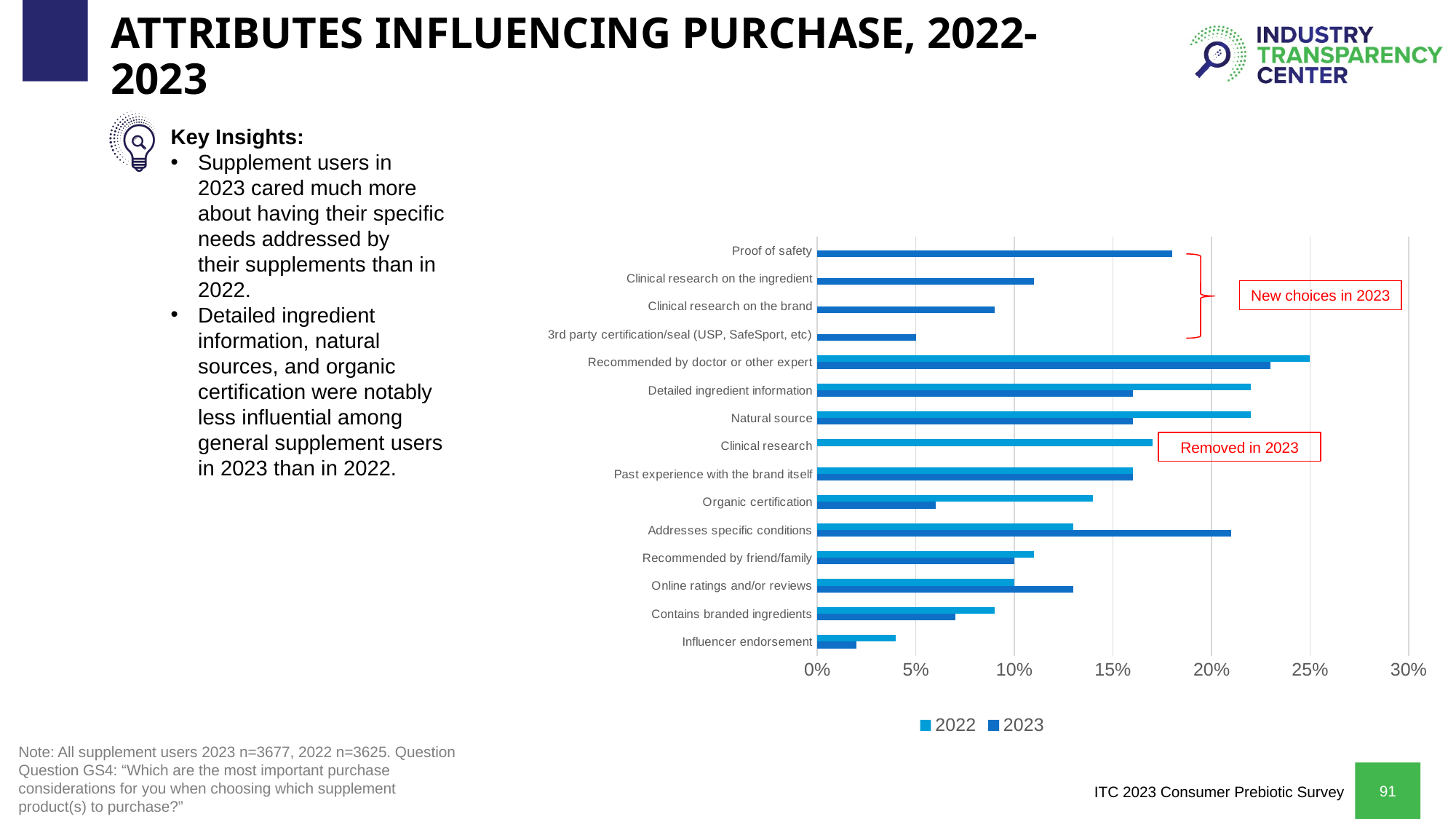
Is the 2023 value for Proof of safety greater or less than 15%? greater Which attribute has the lowest 2023 value? Influencer endorsement For Organic certification, which year has the larger value, 2022 or 2023? 2022 What kind of chart is shown on the slide? Bar chart How many attribute categories are plotted on the chart? 15 How many series does the chart legend list? 2 Is the 2022 value for Influencer endorsement greater or less than 5%? less Is the 2022 value for Addresses specific conditions greater or less than 20%? less For Addresses specific conditions, which year has the larger value, 2022 or 2023? 2023 For Online ratings and/or reviews, which year has the larger value, 2022 or 2023? 2023 What does the red annotation box next to the top four bars say? New choices in 2023 Which attribute has the highest 2022 value? Recommended by doctor or other expert